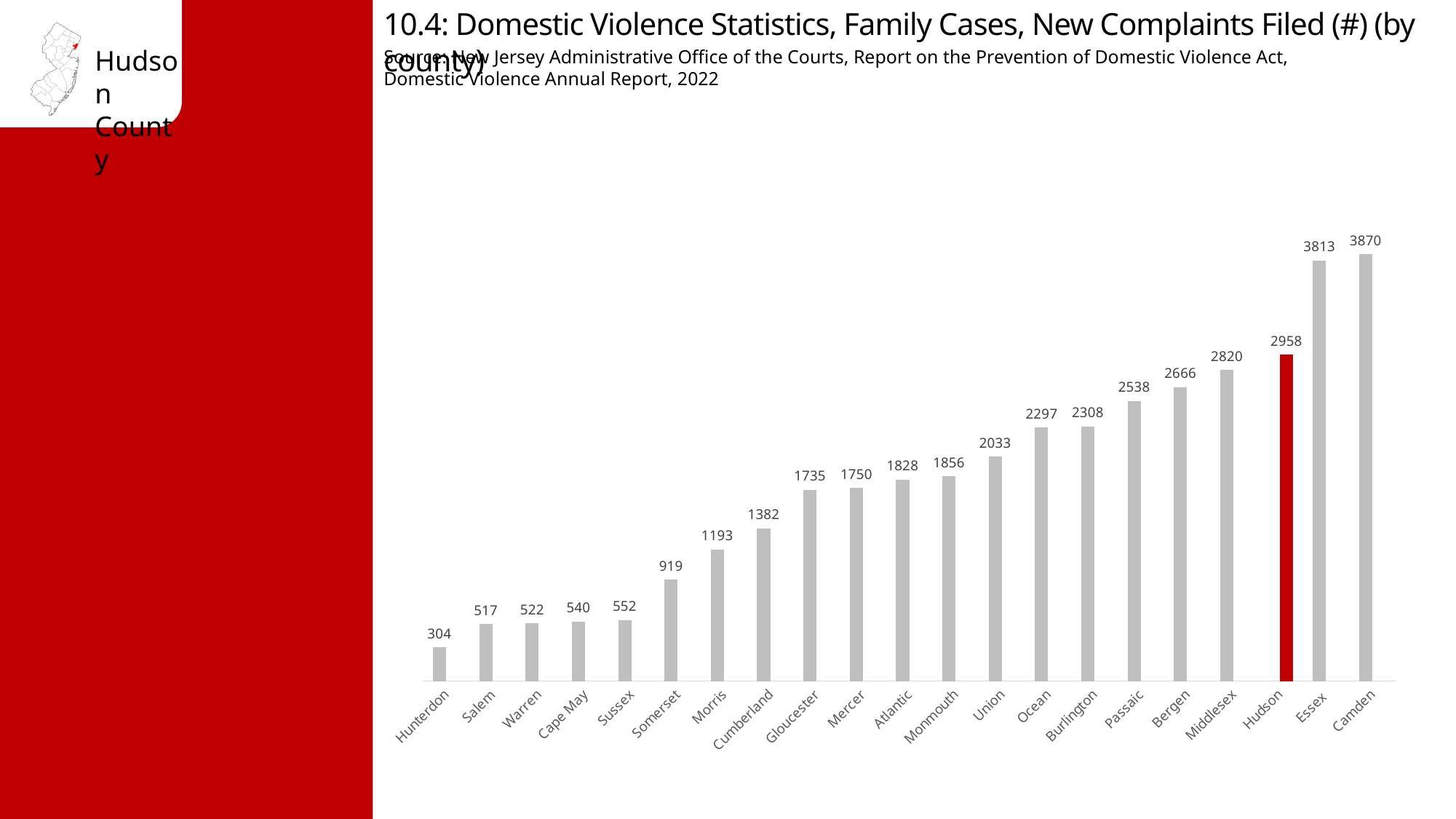
What is the value shown for Hunterdon? 304 How many counties are shown on the chart? 21 What is the difference between the values for Essex and Hudson? 855 Which has a larger value, Bergen or Middlesex? Middlesex Which county's bar is highlighted in red? Hudson What is the value shown for Camden? 3870 What is the number of new domestic violence complaints filed in Hudson County? 2958 Which county has the highest number of new complaints filed? Camden What is the difference between the values for Camden and Hudson? 912 Which county has the lowest number of new complaints filed? Hunterdon What kind of chart is shown on the slide? Bar chart Do the values rise or fall from left to right along the x axis? Rise